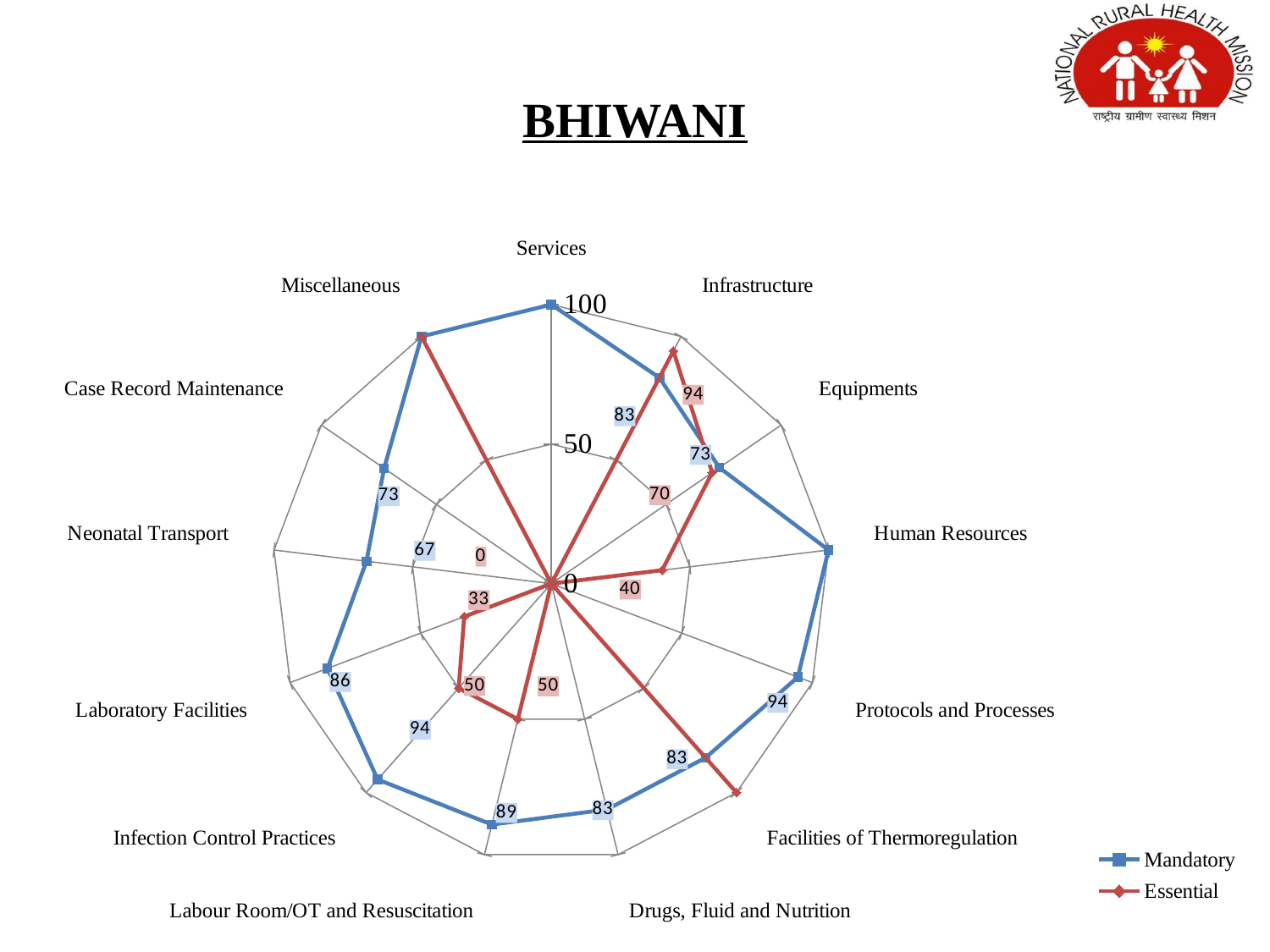
What is the Essential value for Infection Control Practices? 50 What is the Mandatory value for Neonatal Transport? 67 What kind of chart is shown on the slide? Radar chart What is the title of the slide? BHIWANI How many categories are plotted around the radar chart? 13 What is the Essential value for Human Resources? 40 For Infrastructure, which series has the larger value, Mandatory or Essential? Essential What are the two series named in the legend? Mandatory and Essential How many series does the legend list? 2 What is the difference between the Mandatory and Essential values for Drugs, Fluid and Nutrition? 83 What is the Mandatory value for Protocols and Processes? 94 Is the Mandatory value for Human Resources greater or less than 50? greater